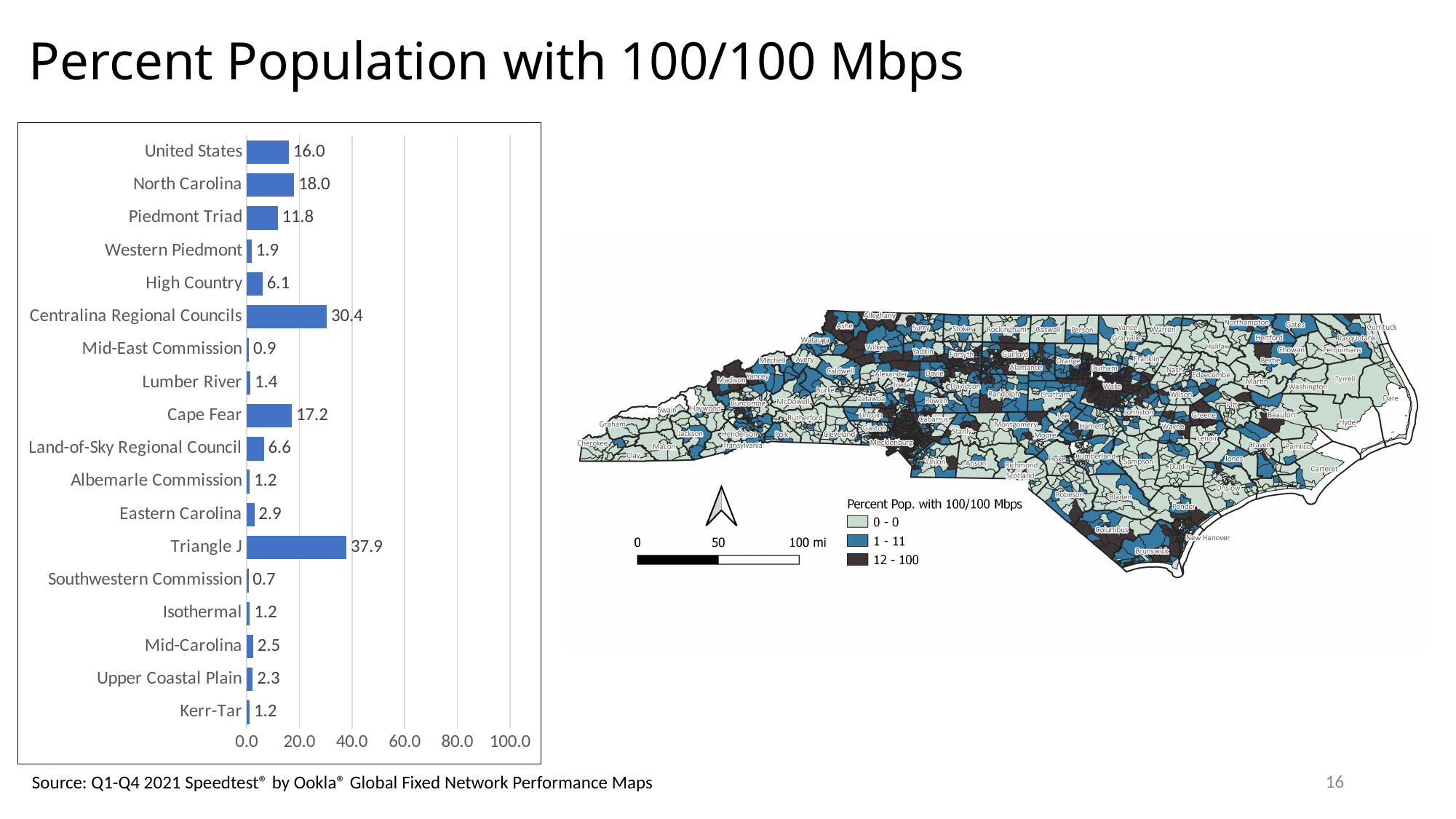
What kind of chart is shown on the left of the slide? Bar chart How many categories are shown in the bar chart? 18 What is the title of the slide containing the bar chart? Percent Population with 100/100 Mbps What is the value for Triangle J in the bar chart? 37.9 What is the difference between the values for North Carolina and United States in the bar chart? 2.0 Which is larger in the bar chart, Cape Fear or Piedmont Triad? Cape Fear What is the value for Mid-East Commission in the bar chart? 0.9 What is the difference between the values for Triangle J and Centralina Regional Councils in the bar chart? 7.5 What is the value for North Carolina in the bar chart? 18.0 Which category has the lowest value in the bar chart? Southwestern Commission Which category has the highest value in the bar chart? Triangle J What is the value for Centralina Regional Councils in the bar chart? 30.4